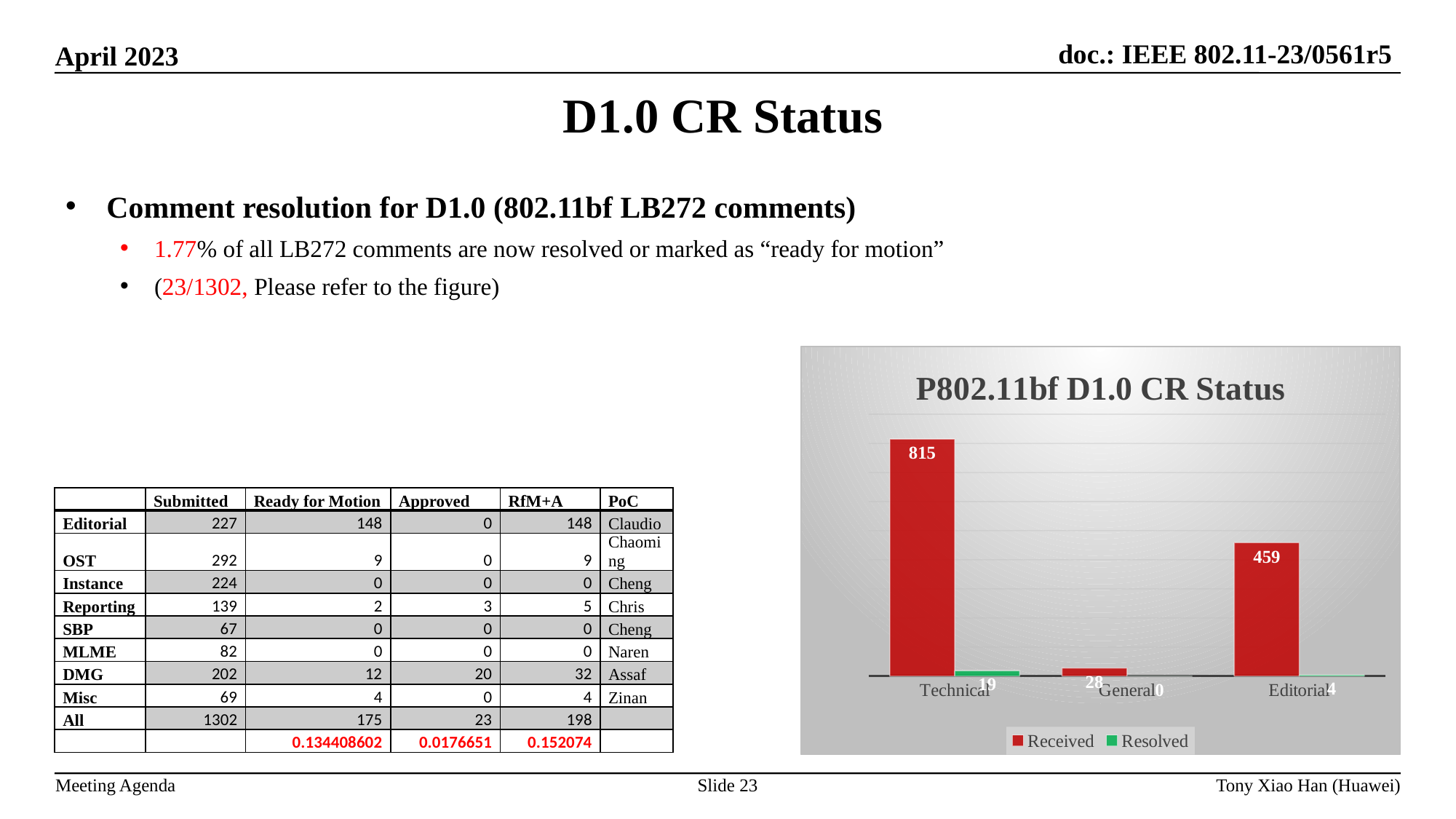
Which is larger, the Resolved value for Technical or the Resolved value for Editorial? Technical What is the title of the chart on the slide? P802.11bf D1.0 CR Status What is the difference between the Received values for Technical and Editorial? 356 What is the Received value for Technical? 815 How many categories are shown on the x axis of the chart? 3 What is the Received value for General? 28 What type of chart is shown on the slide? bar chart What is the Received value for Editorial? 459 How many series does the chart legend list? 2 What is the Resolved value for Technical? 19 Which category has the highest Received value? Technical Which category has the lowest Received value? General